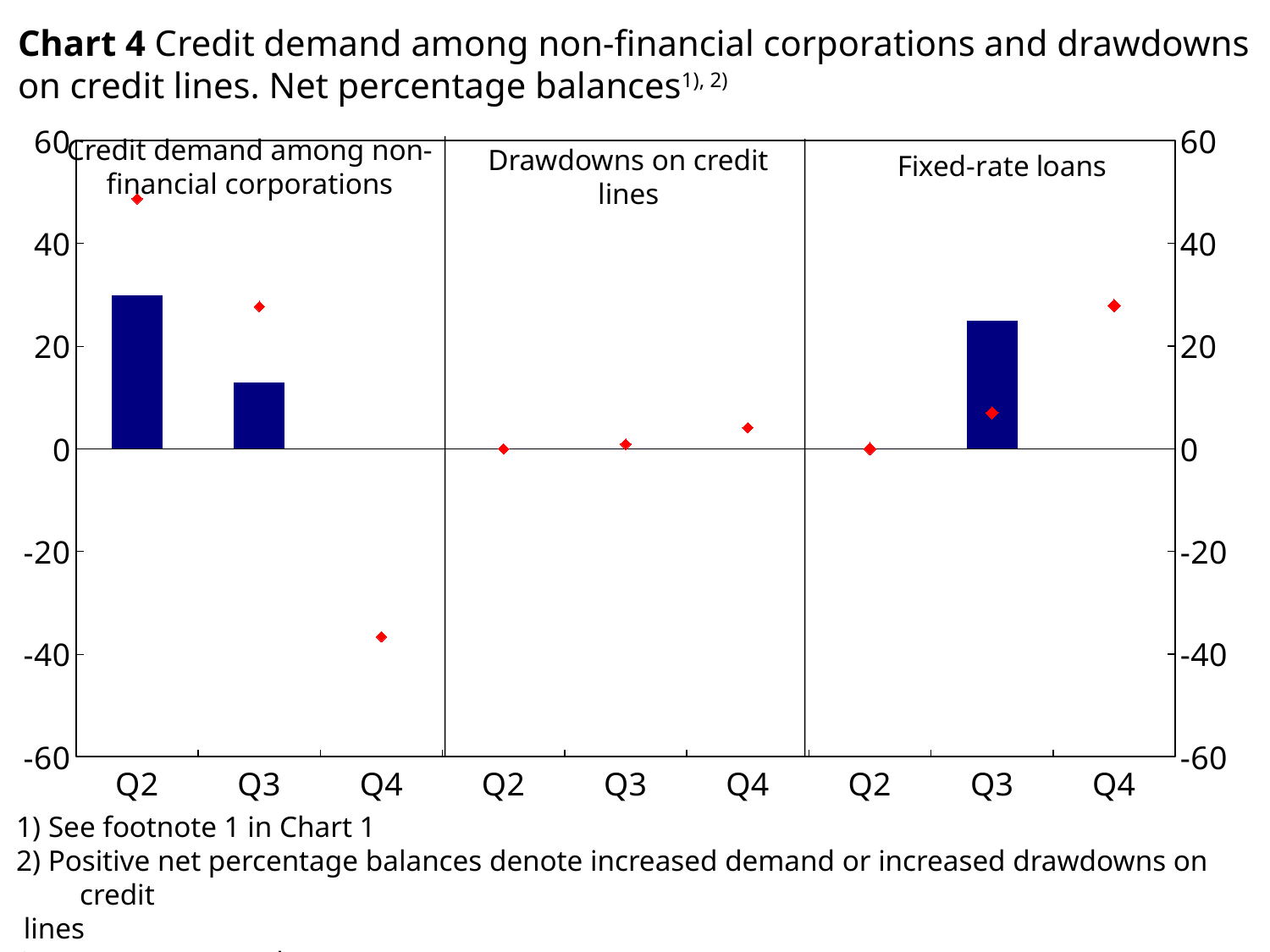
How many panels does the chart have? 3 In the 'Credit demand among non-financial corporations' panel, is the red diamond for Q4 greater or less than -20? less In the 'Credit demand among non-financial corporations' panel, is the bar for Q3 greater or less than 20? less In the 'Fixed-rate loans' panel, is the bar for Q3 greater or less than 20? greater In the 'Credit demand among non-financial corporations' panel, which quarter has the higher bar, Q2 or Q3? Q2 In the 'Credit demand among non-financial corporations' panel, which quarter has the lowest red diamond? Q4 What is the title of the rightmost panel of the chart? Fixed-rate loans What type of chart is shown on the slide? bar chart with diamond markers (combination bar and line chart) What is the maximum value shown on the vertical axis of the chart? 60 How many quarters are shown on the x axis of each panel? 3 In the 'Fixed-rate loans' panel, which quarter has the highest red diamond? Q4